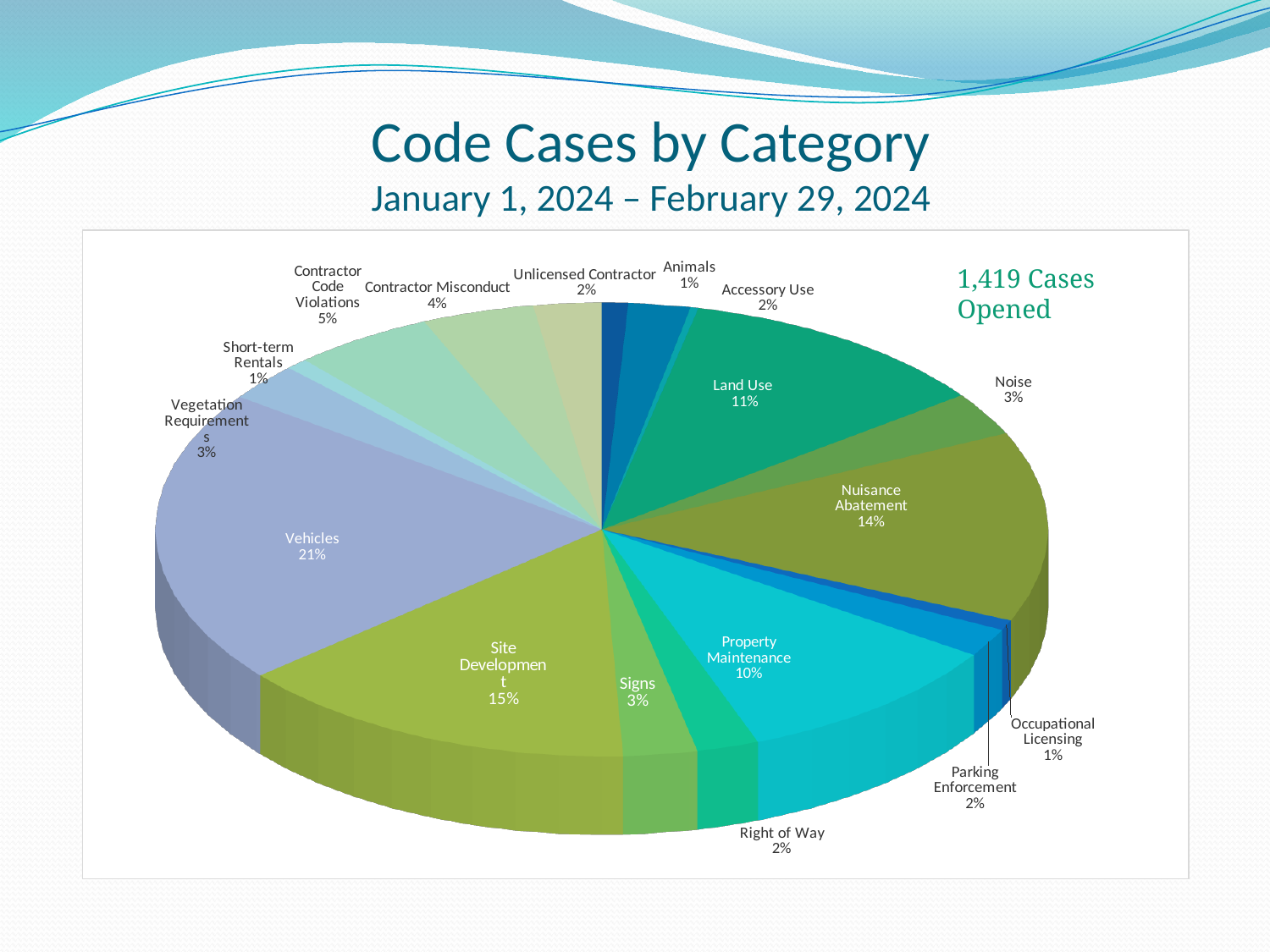
How many cases were opened in total according to the slide? 1,419 What kind of chart is shown on the slide? pie chart Which category has the largest share of code cases? Vehicles What share of code cases is Contractor Code Violations? 5% What share of code cases is Site Development? 15% Which has a larger share, Land Use or Property Maintenance? Land Use How many categories are shown in the pie chart? 17 What is the difference in percentage points between Vehicles and Site Development? 6 What share of code cases is Property Maintenance? 10% What is the difference in percentage points between Nuisance Abatement and Land Use? 3